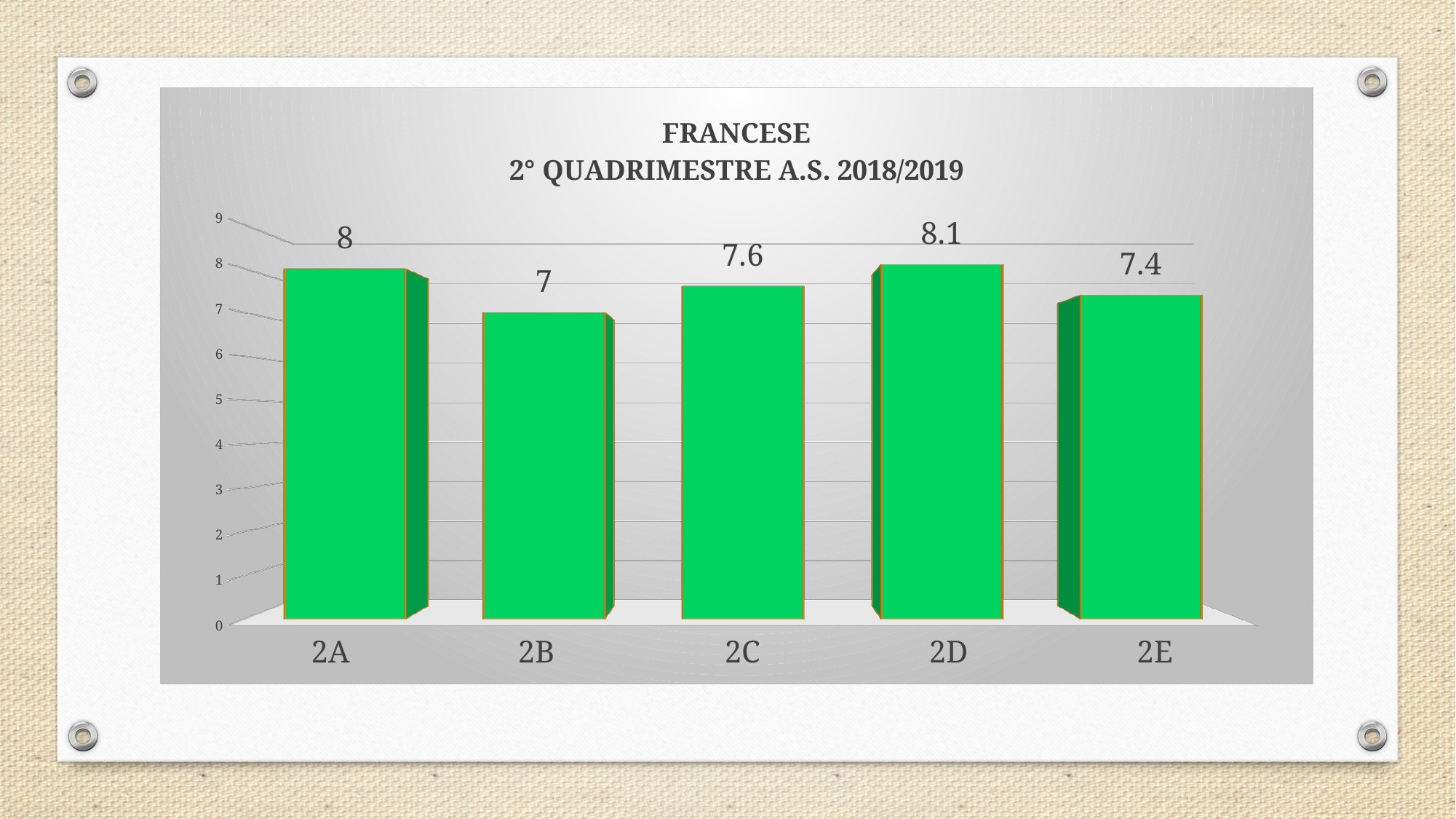
What is the difference between the values for 2D and 2B? 1.1 Is the value for 2B greater or less than 8? less Which class has the lowest value? 2B What is the title of the chart? FRANCESE 2° QUADRIMESTRE A.S. 2018/2019 What is the value for 2C? 7.6 Which class has the highest value? 2D What is the value for 2A? 8 Which is larger, the value for 2C or the value for 2E? 2C What kind of chart is shown on the slide? bar chart What is the difference between the values for 2A and 2E? 0.6 What is the value for 2E? 7.4 How many classes are shown on the x axis? 5